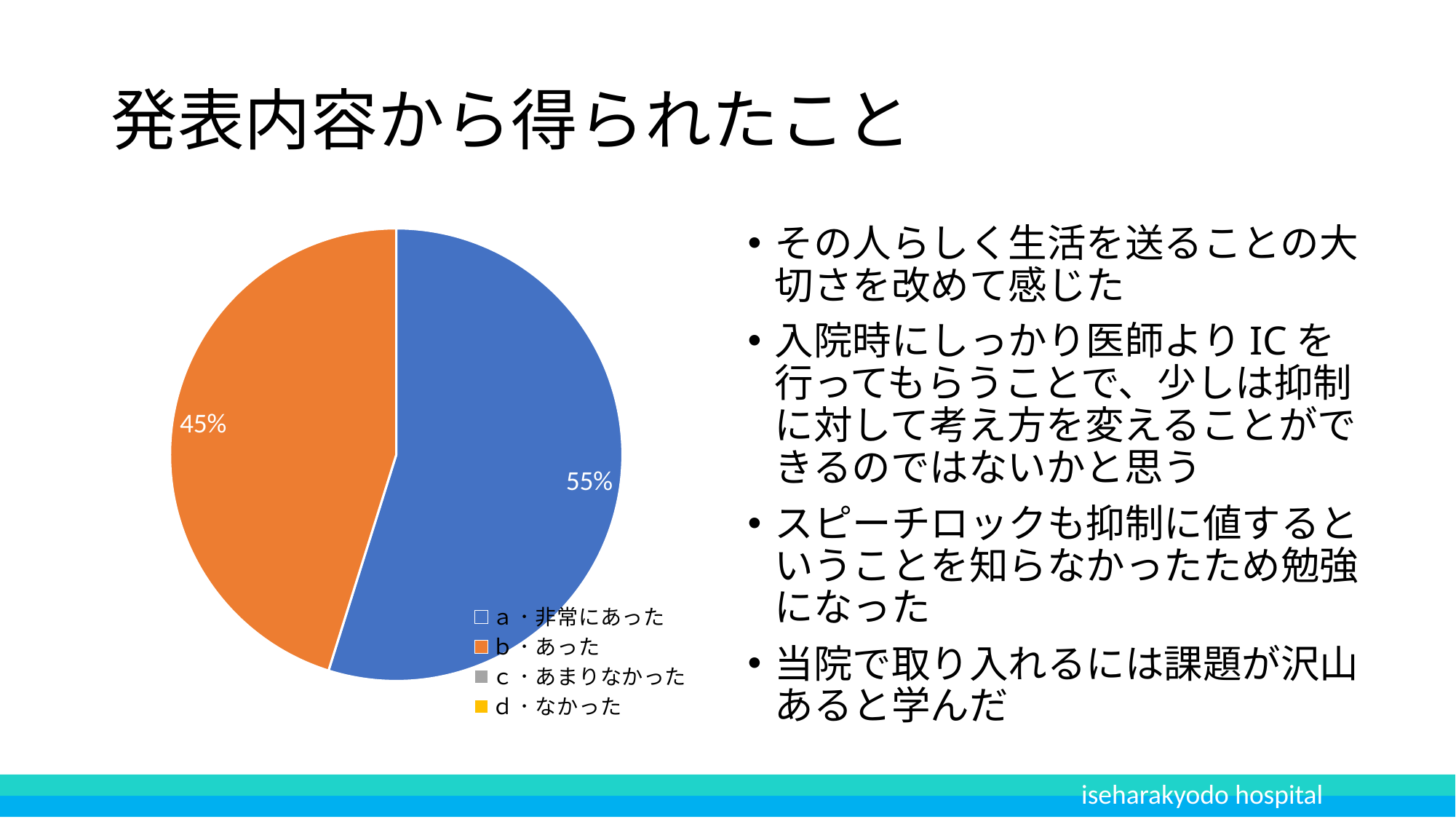
What share of the pie does the slice for a・非常にあった represent? 55% What is the difference in percentage points between the slice for a・非常にあった and the slice for b・あった? 10 percentage points How many slices are visible in the pie chart? 2 Is the share for b・あった greater or less than 50%? less How many entries does the legend of the pie chart list? 4 Which category has the largest slice of the pie? a・非常にあった Which is larger, the slice for a・非常にあった or the slice for b・あった? a・非常にあった What share of the pie does the slice for b・あった represent? 45% What colour is the slice for b・あった? orange What kind of chart is shown on the slide? pie chart What colour is the slice for a・非常にあった? blue